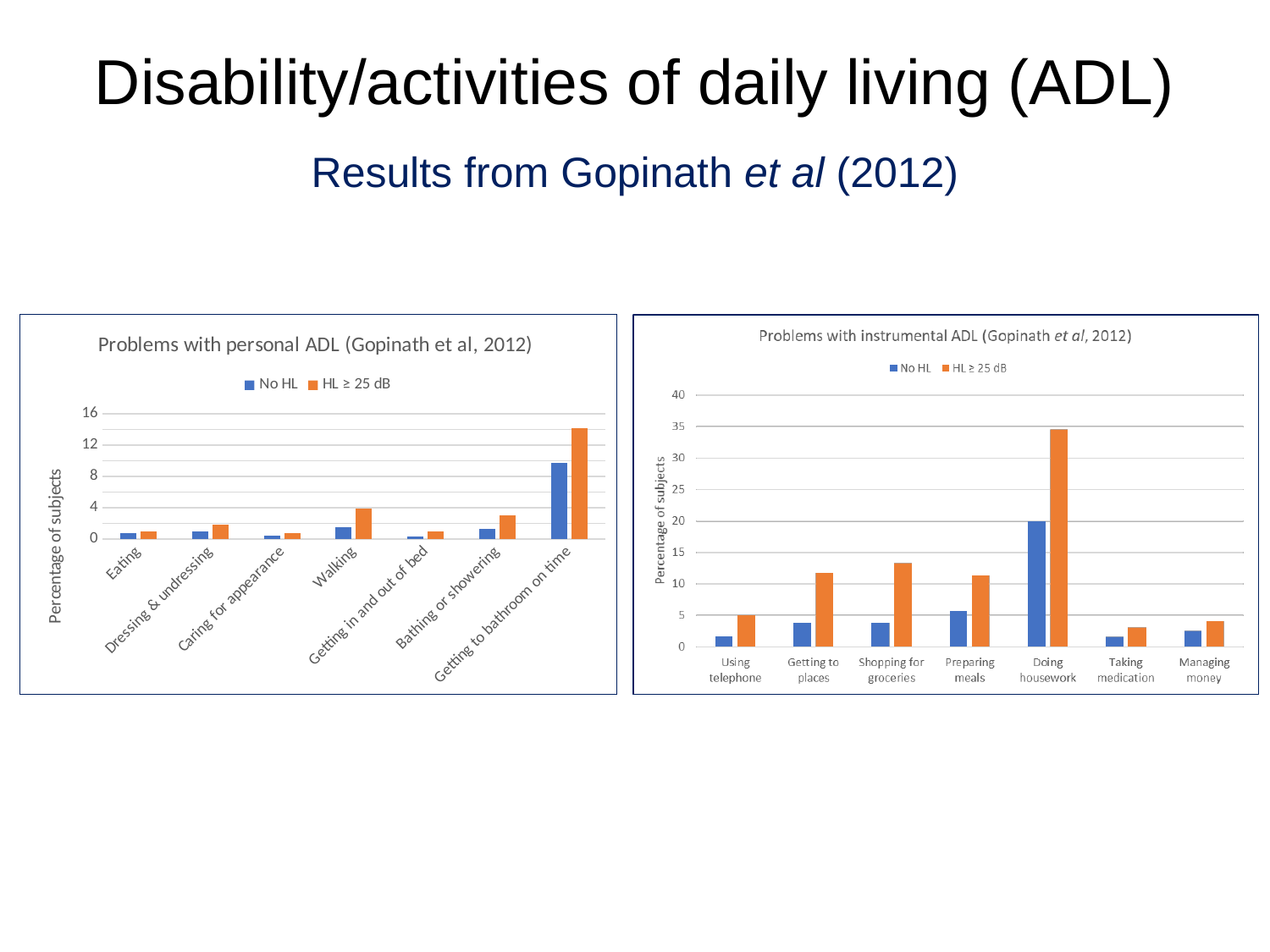
What type of chart is the 'Problems with personal ADL' chart? Bar chart In the 'Problems with personal ADL' chart, which category has the highest value for HL ≥ 25 dB? Getting to bathroom on time In the 'Problems with instrumental ADL' chart, how many series does the legend list? 2 In the 'Problems with personal ADL' chart, how many activity categories are shown on the x axis? 7 In the 'Problems with personal ADL' chart, which has the larger HL ≥ 25 dB value: Walking or Bathing or showering? Walking In the 'Problems with personal ADL' chart, is the No HL value for Getting to bathroom on time greater or less than 8? greater In the 'Problems with instrumental ADL' chart, is the No HL value for Doing housework greater or less than 15? greater What is the y-axis label of the 'Problems with personal ADL' chart? Percentage of subjects In the 'Problems with instrumental ADL' chart, which category has the highest value for HL ≥ 25 dB? Doing housework In the 'Problems with instrumental ADL' chart, is the HL ≥ 25 dB value for Doing housework greater or less than 30? greater In the 'Problems with instrumental ADL' chart, which has the larger HL ≥ 25 dB value: Getting to places or Shopping for groceries? Shopping for groceries